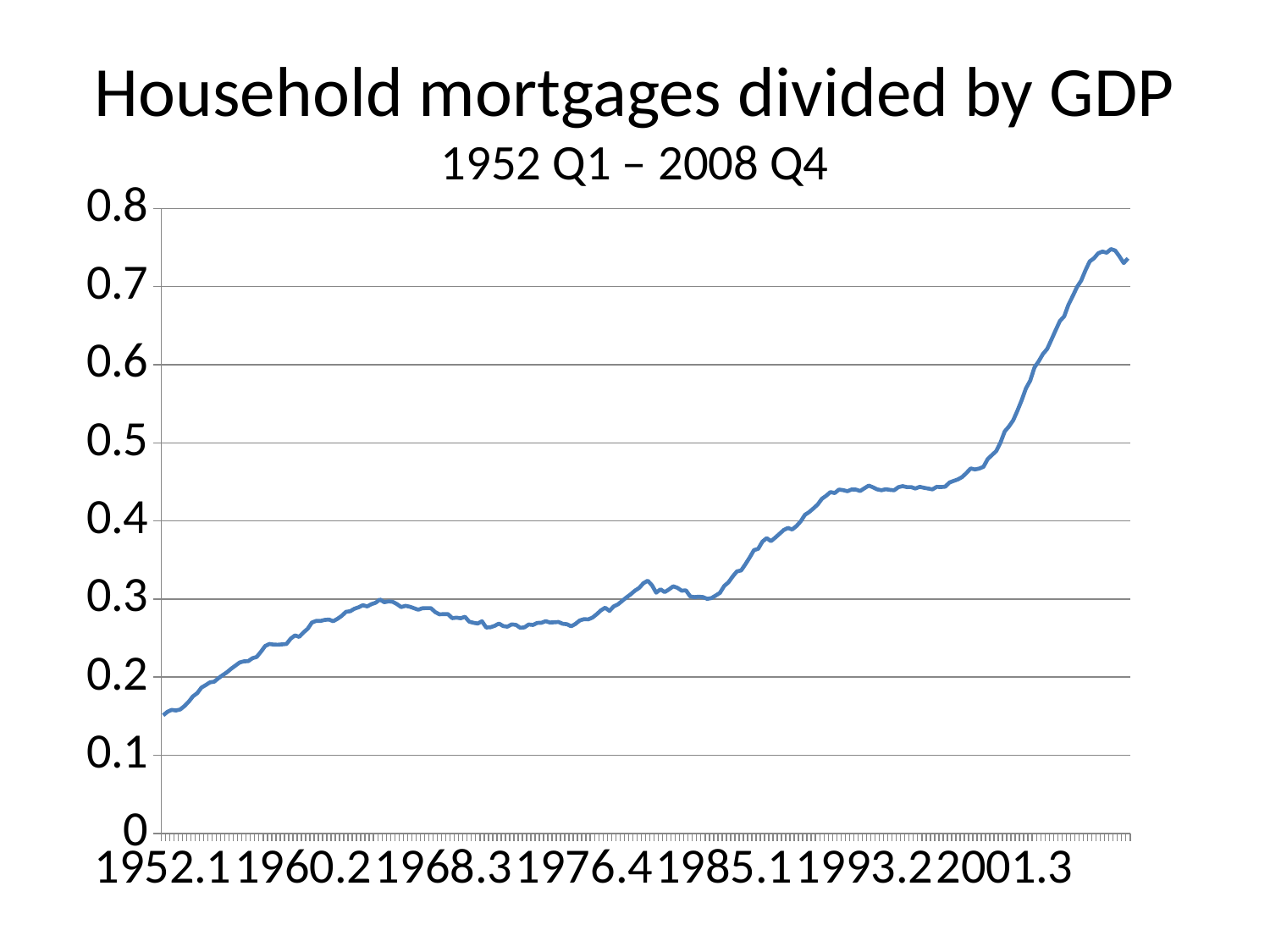
Is the value at 1952.1 greater or less than 0.2? less What is the title of the chart? Household mortgages divided by GDP What kind of chart is shown on the slide? line chart Is the highest point of the line greater or less than 0.7? greater What period does the chart's subtitle say the data covers? 1952 Q1 – 2008 Q4 Is the value at 1993.2 greater or less than 0.4? greater Overall, does the household mortgages to GDP ratio rise or fall from 1952 to 2008? rise Which is larger, the value at 1993.2 or the value at 1976.4? 1993.2